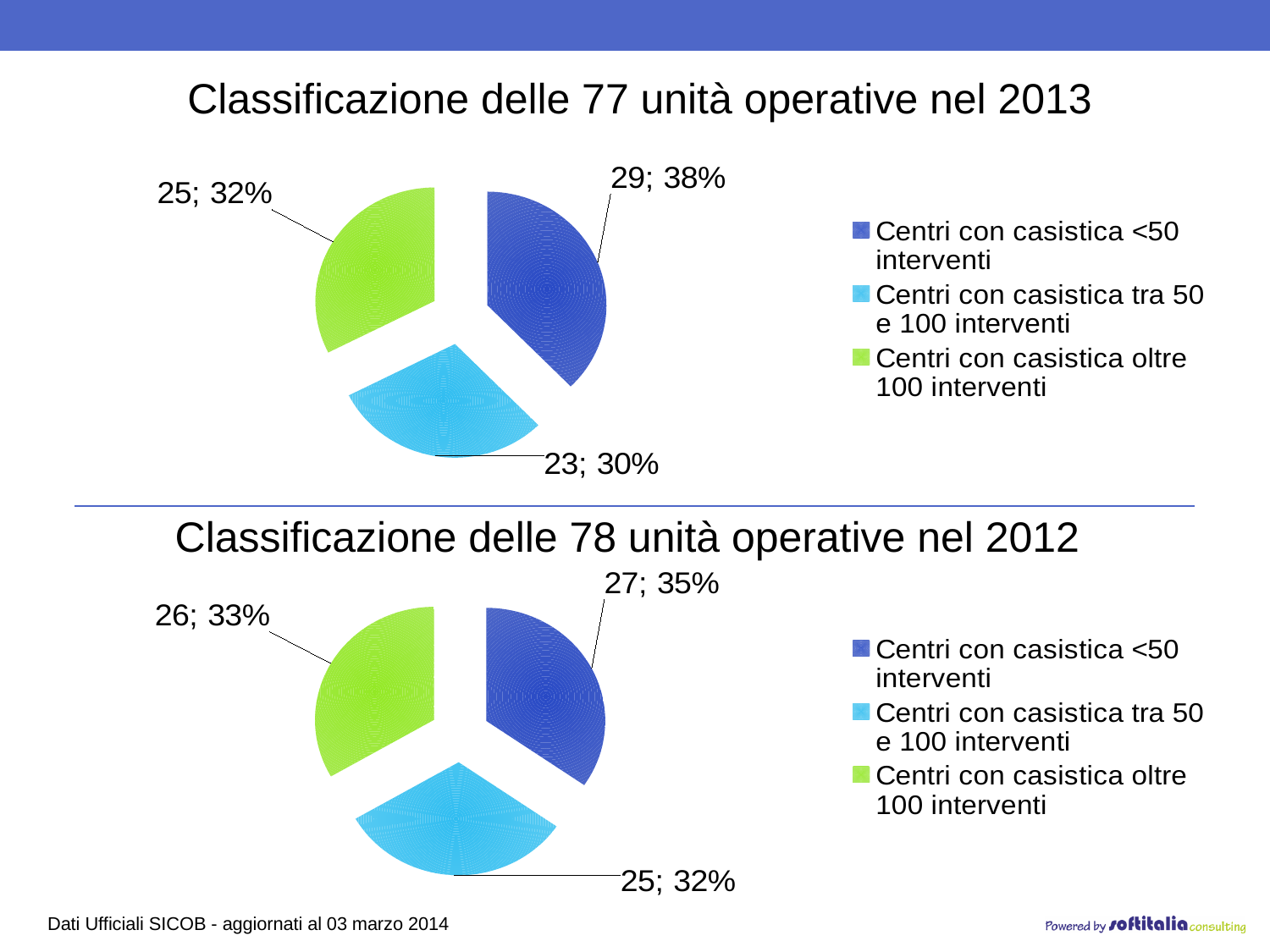
In the chart 'Classificazione delle 77 unità operative nel 2013', which category has the largest slice? Centri con casistica <50 interventi In the chart 'Classificazione delle 77 unità operative nel 2013', what share of the pie is 'Centri con casistica tra 50 e 100 interventi'? 30% In the chart 'Classificazione delle 77 unità operative nel 2013', how many centres have 'casistica <50 interventi'? 29 In the chart 'Classificazione delle 78 unità operative nel 2012', what colour is the slice for 'Centri con casistica oltre 100 interventi'? Green How many categories does the legend of the chart 'Classificazione delle 77 unità operative nel 2013' list? 3 In the chart 'Classificazione delle 78 unità operative nel 2012', what share of the pie is 'Centri con casistica <50 interventi'? 35% In the chart 'Classificazione delle 78 unità operative nel 2012', which is larger: the number of centres with tra 50 e 100 interventi or with oltre 100 interventi? Centri con casistica oltre 100 interventi In the chart 'Classificazione delle 77 unità operative nel 2013', which category has the smallest slice? Centri con casistica tra 50 e 100 interventi In the chart 'Classificazione delle 78 unità operative nel 2012', which category has the largest slice? Centri con casistica <50 interventi In the chart 'Classificazione delle 77 unità operative nel 2013', what is the difference between the number of centres with <50 interventi and those with oltre 100 interventi? 4 In the chart 'Classificazione delle 78 unità operative nel 2012', how many centres have 'casistica oltre 100 interventi'? 26 What type of chart is used on this slide? Pie chart